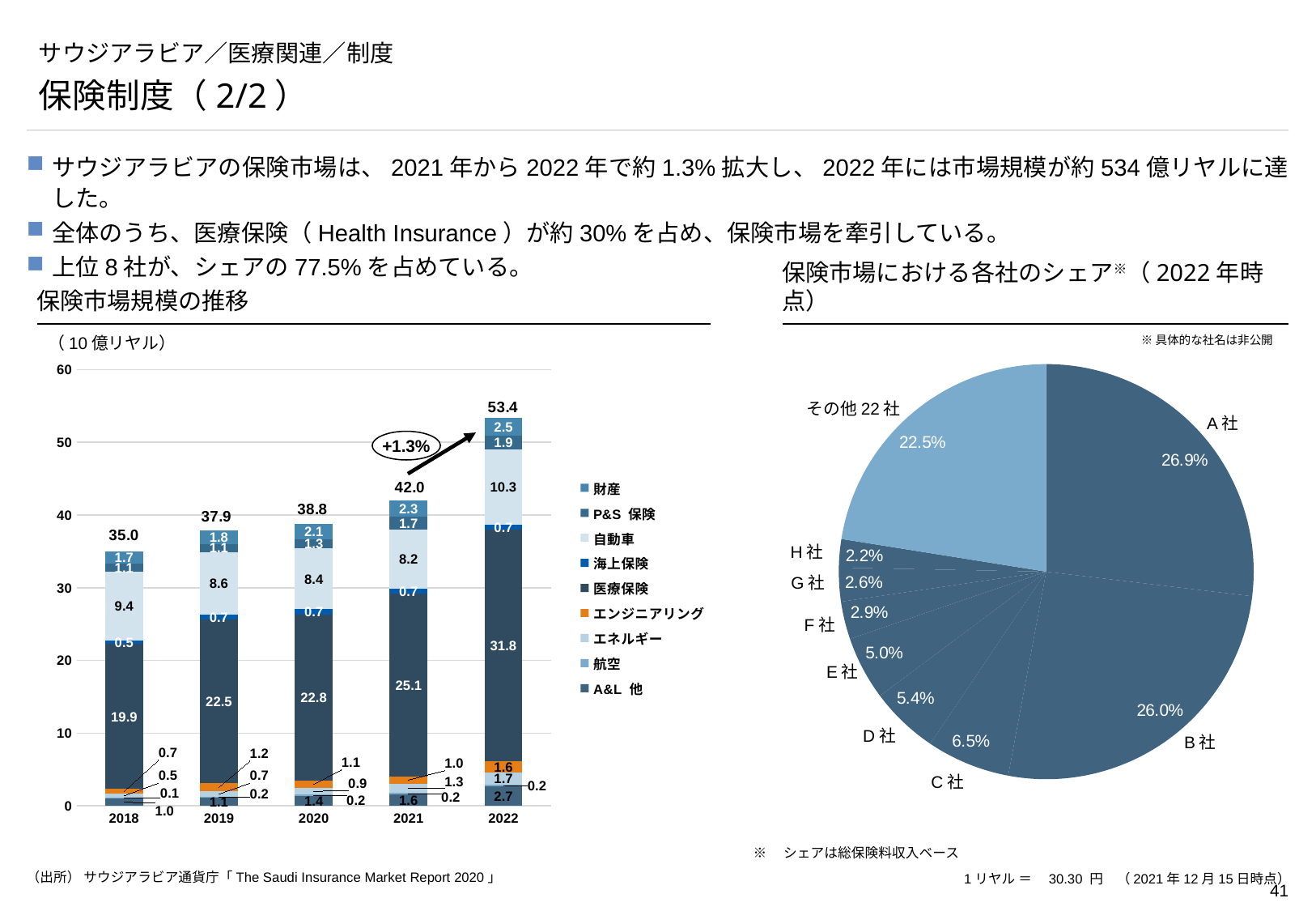
In the bar chart 保険市場規模の推移, do the total values rise or fall from 2018 to 2022? rise In the bar chart 保険市場規模の推移, is the 自動車 value for 2020 larger or smaller than the 自動車 value for 2022? smaller In the pie chart 保険市場における各社のシェア, what share does A社 hold? 26.9% In the bar chart 保険市場規模の推移, what is the total market size shown for 2022? 53.4 In the pie chart 保険市場における各社のシェア, how many slices are shown? 9 In the pie chart 保険市場における各社のシェア, which company has the smallest share? H社 In the bar chart 保険市場規模の推移, what is the value of 医療保険 in 2021? 25.1 In the bar chart 保険市場規模の推移, how many series does the legend list? 9 What kind of chart is 保険市場規模の推移? stacked bar chart In the bar chart 保険市場規模の推移, which year has the lowest total market size? 2018 In the bar chart 保険市場規模の推移, what is the difference between the total for 2022 and the total for 2021? 11.4 In the bar chart 保険市場規模の推移, which year has the highest total market size? 2022